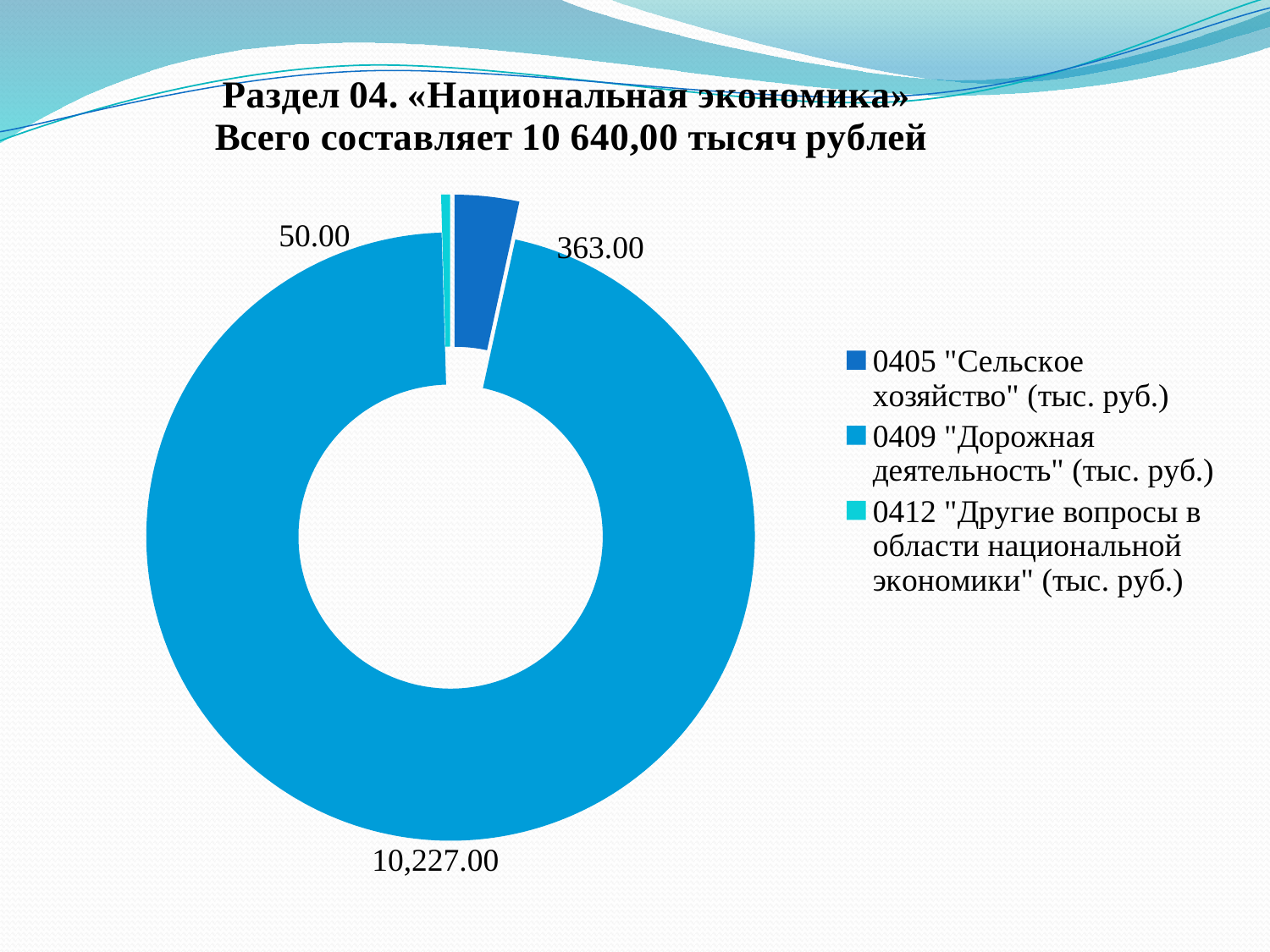
What is the difference between the values for 0405 "Сельское хозяйство" and 0412 "Другие вопросы в области национальной экономики"? 313.00 What kind of chart is shown on the slide? Doughnut (pie) chart What is the value for 0412 "Другие вопросы в области национальной экономики" (тыс. руб.)? 50.00 What is the total of all the slices in the chart? 10,640.00 Which is larger: the value for 0405 "Сельское хозяйство" or the value for 0412 "Другие вопросы в области национальной экономики"? 0405 "Сельское хозяйство" What colour is the slice for 0412 "Другие вопросы в области национальной экономики"? Cyan (light turquoise) Which category has the smallest slice of the chart? 0412 "Другие вопросы в области национальной экономики" (тыс. руб.) What is the difference between the values for 0409 "Дорожная деятельность" and 0405 "Сельское хозяйство"? 9,864.00 What is the value for 0409 "Дорожная деятельность" (тыс. руб.)? 10,227.00 How many categories are shown in the chart? 3 What is the value for 0405 "Сельское хозяйство" (тыс. руб.)? 363.00 Which category has the largest slice of the chart? 0409 "Дорожная деятельность" (тыс. руб.)